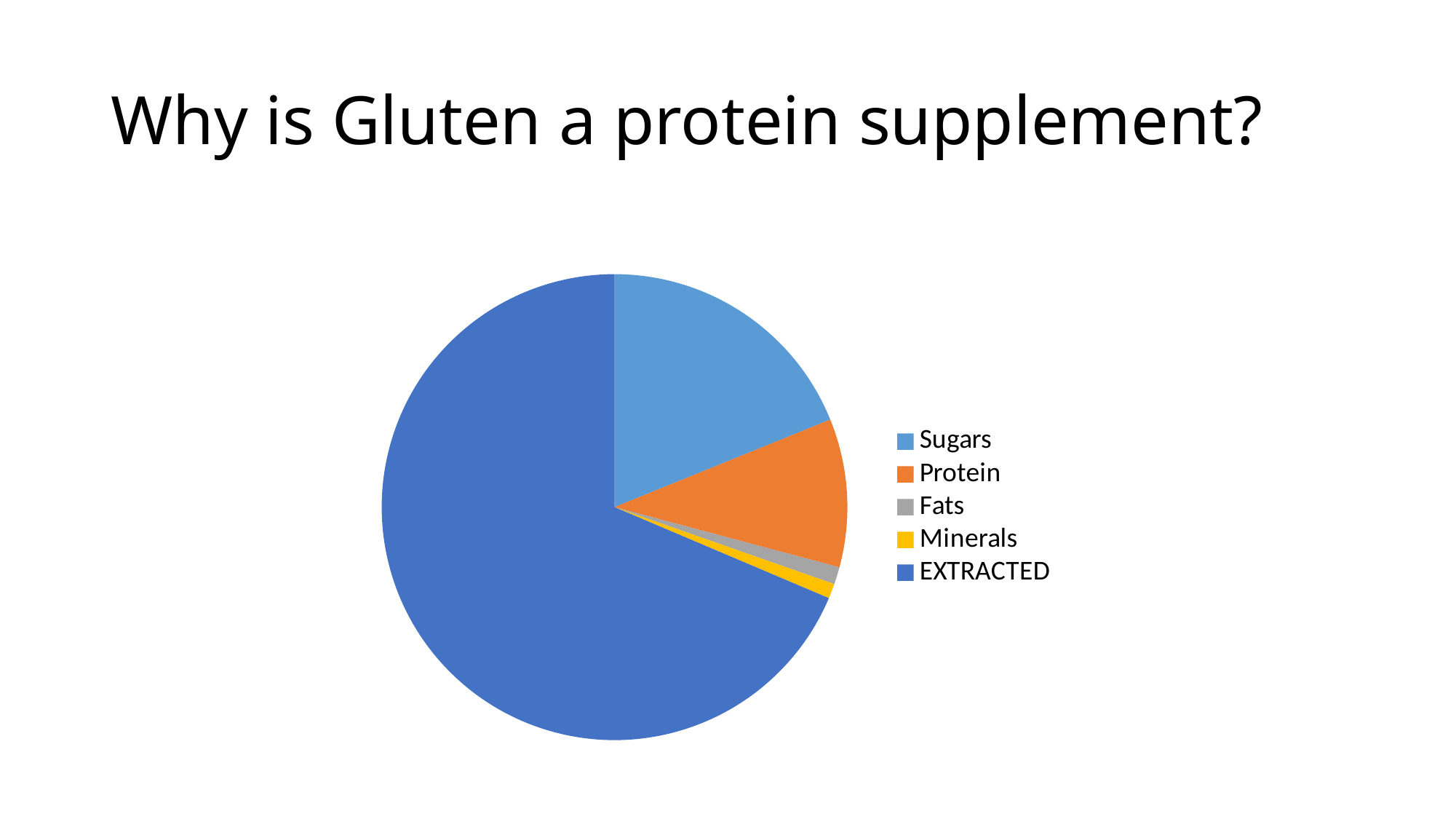
What kind of chart is shown on the slide? pie chart Which is larger in the pie chart, Protein or Minerals? Protein Which category has the largest slice of the pie chart? EXTRACTED What is the title of the slide containing the pie chart? Why is Gluten a protein supplement? Which is larger in the pie chart, Sugars or Protein? Sugars Which is larger in the pie chart, Protein or Fats? Protein Does the EXTRACTED slice take up more or less than half of the pie chart? more What colour is the Minerals slice in the pie chart? yellow How many categories does the pie chart have? 5